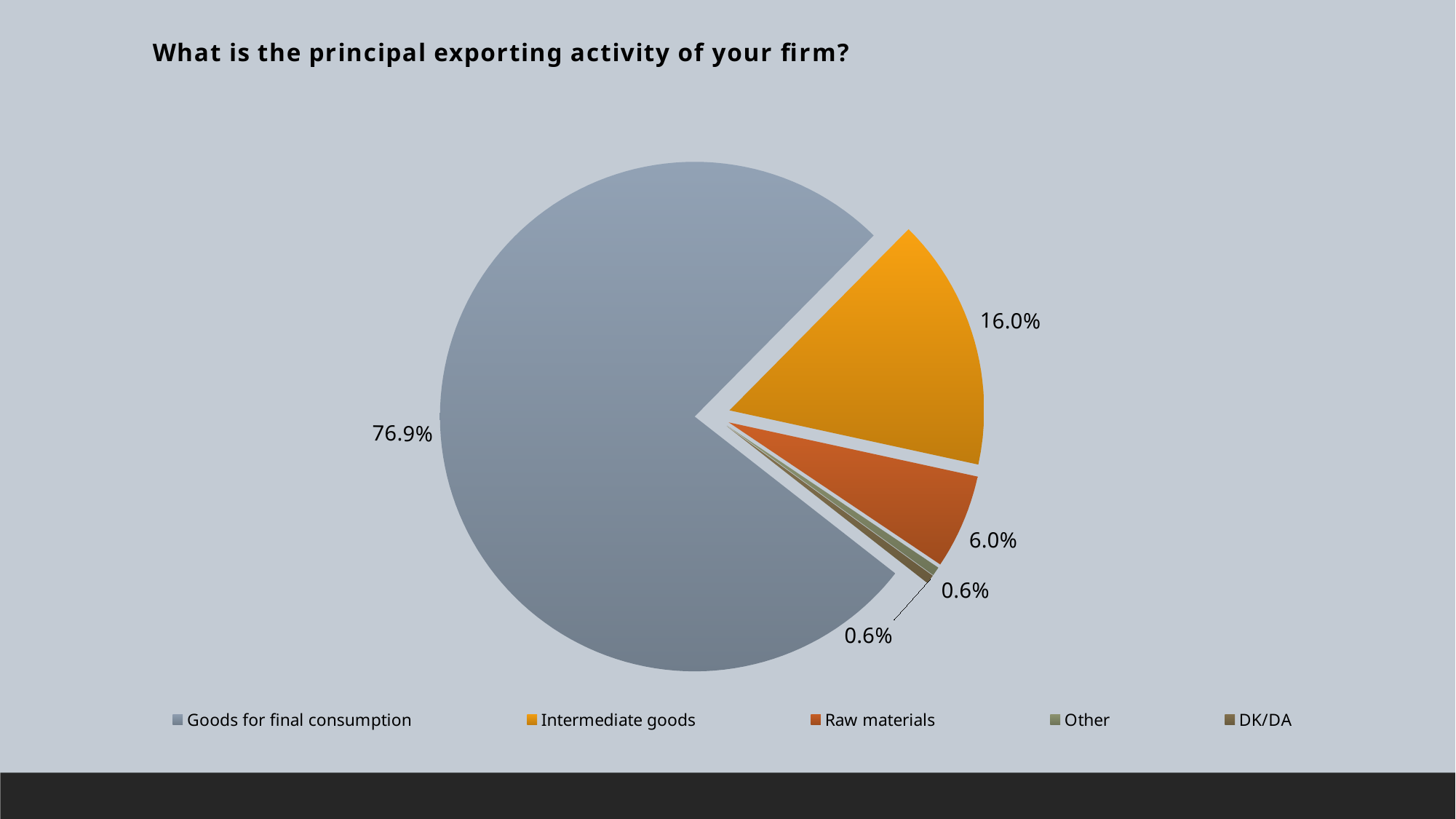
What share of the pie is Raw materials? 6.0% What is the difference between the share for Intermediate goods and the share for Raw materials? 10.0% What share of the pie is Other? 0.6% Which category has the largest slice of the pie? Goods for final consumption What is the title of the chart? What is the principal exporting activity of your firm? What kind of chart is shown on the slide? Pie chart How many categories does the legend list? 5 What share of the pie is Goods for final consumption? 76.9% Which is larger, the share for Intermediate goods or the share for Raw materials? Intermediate goods What colour is the Intermediate goods slice? Orange